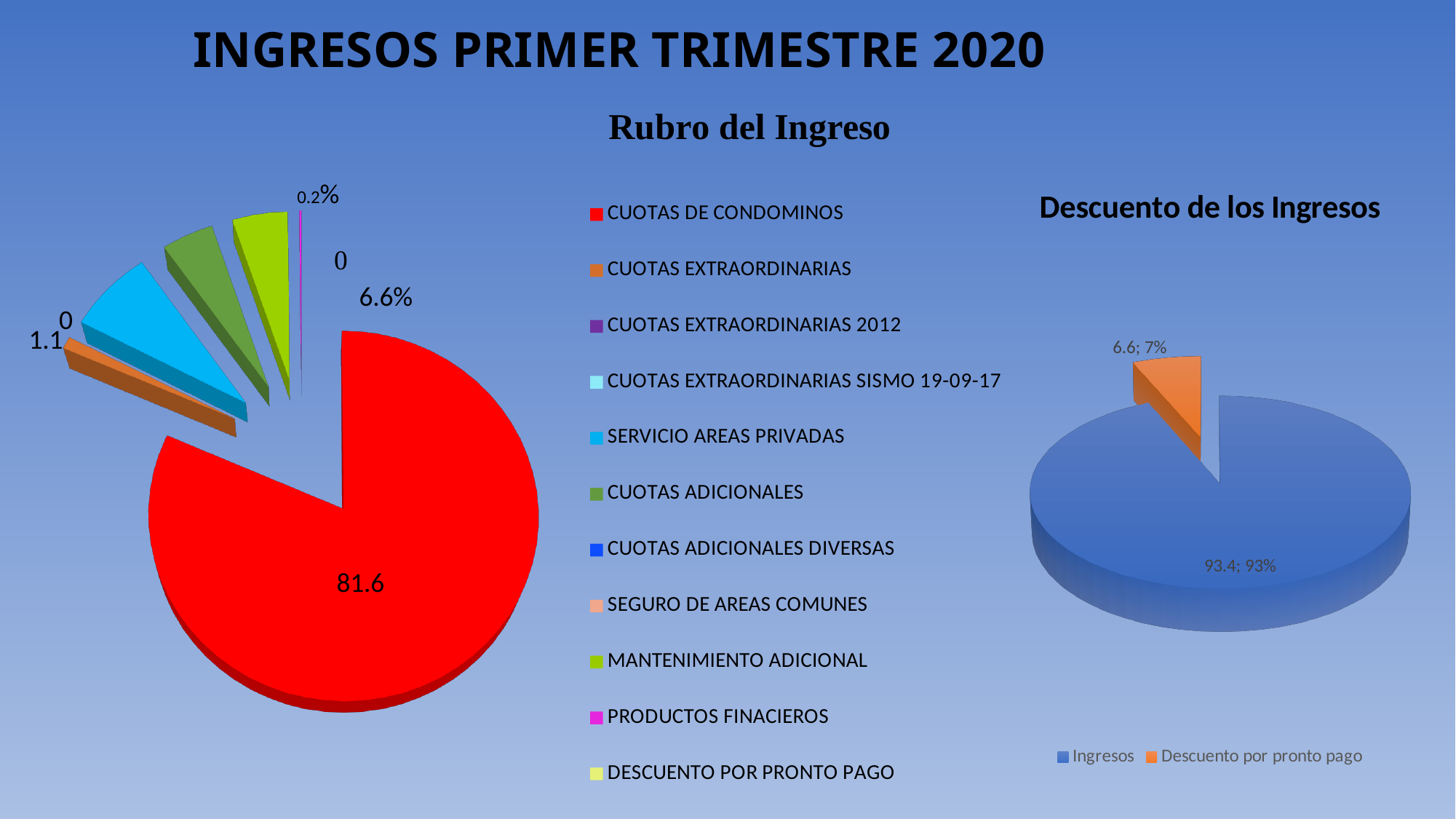
In the 'Descuento de los Ingresos' chart, what value is shown for Descuento por pronto pago? 6.6; 7% In the 'Rubro del Ingreso' chart, which category has the largest slice? CUOTAS DE CONDOMINOS In the 'Descuento de los Ingresos' chart, which is larger, Ingresos or Descuento por pronto pago? Ingresos In the 'Rubro del Ingreso' chart, what value is shown for CUOTAS DE CONDOMINOS? 81.6 In the 'Descuento de los Ingresos' chart, what share of the pie does Ingresos take? 93% In the 'Descuento de los Ingresos' chart, what is the difference between the Ingresos value and the Descuento por pronto pago value? 86.8 How many entries does the legend of the 'Descuento de los Ingresos' chart list? 2 In the 'Descuento de los Ingresos' chart, what value is shown for Ingresos? 93.4; 93% What colour is the Descuento por pronto pago slice in the 'Descuento de los Ingresos' chart? Orange How many entries does the legend of the 'Rubro del Ingreso' chart list? 11 What kind of chart is 'Rubro del Ingreso'? Pie chart In the 'Rubro del Ingreso' chart, what value is labelled on the thin magenta slice for PRODUCTOS FINACIEROS? 0.2%